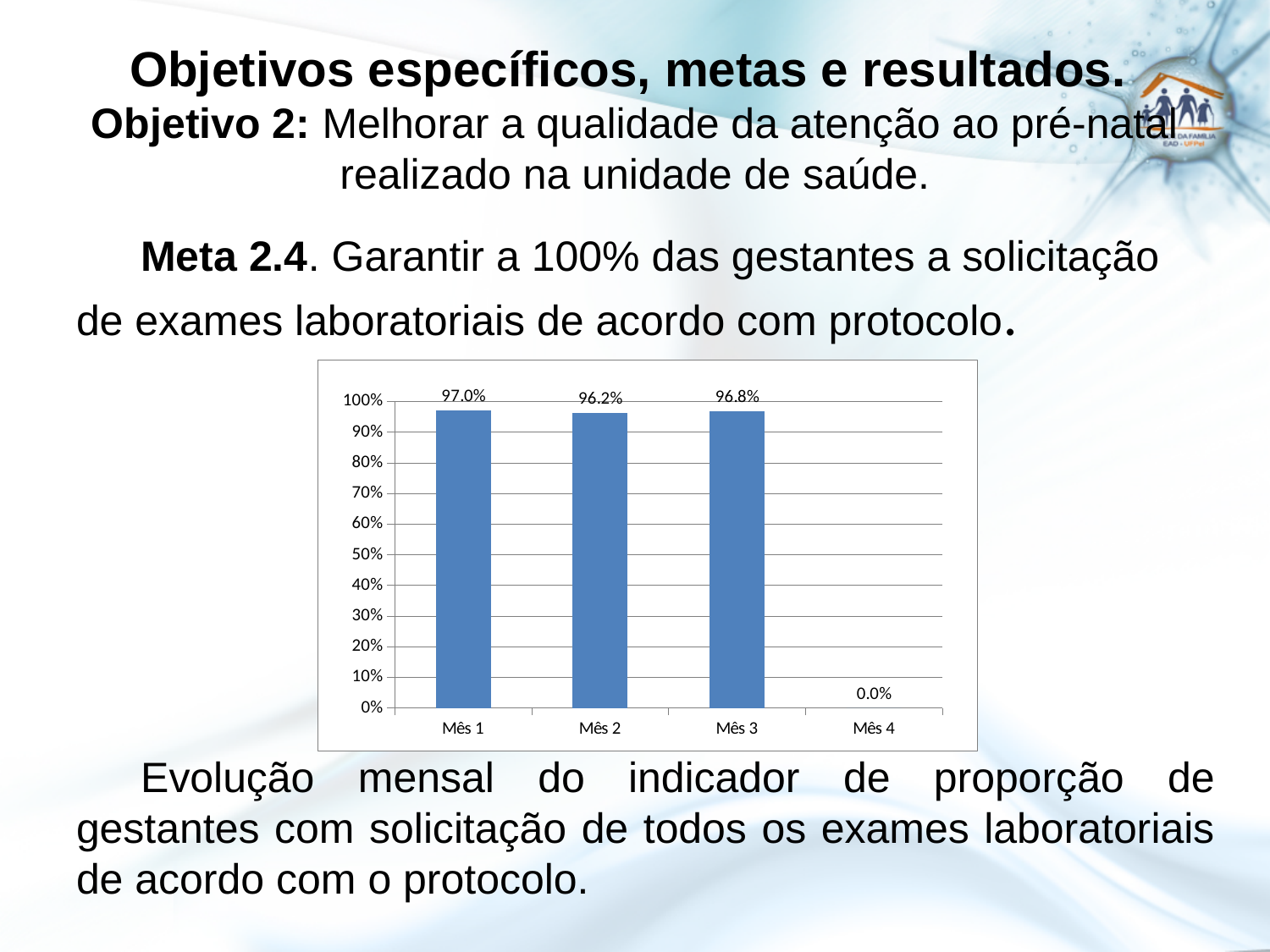
Which month has the highest value? Mês 1 What kind of chart is shown on the slide? Bar chart Which month has the lowest value? Mês 4 What is the difference between the values for Mês 1 and Mês 2? 0.8% What is the difference between the values for Mês 3 and Mês 2? 0.6% What is the value for Mês 2? 96.2% What is the value for Mês 1? 97.0% What is the highest tick value shown on the y axis? 100% What is the value for Mês 3? 96.8% How many months are shown on the x axis? 4 What is the value for Mês 4? 0.0% Which is larger, the value for Mês 1 or the value for Mês 2? Mês 1